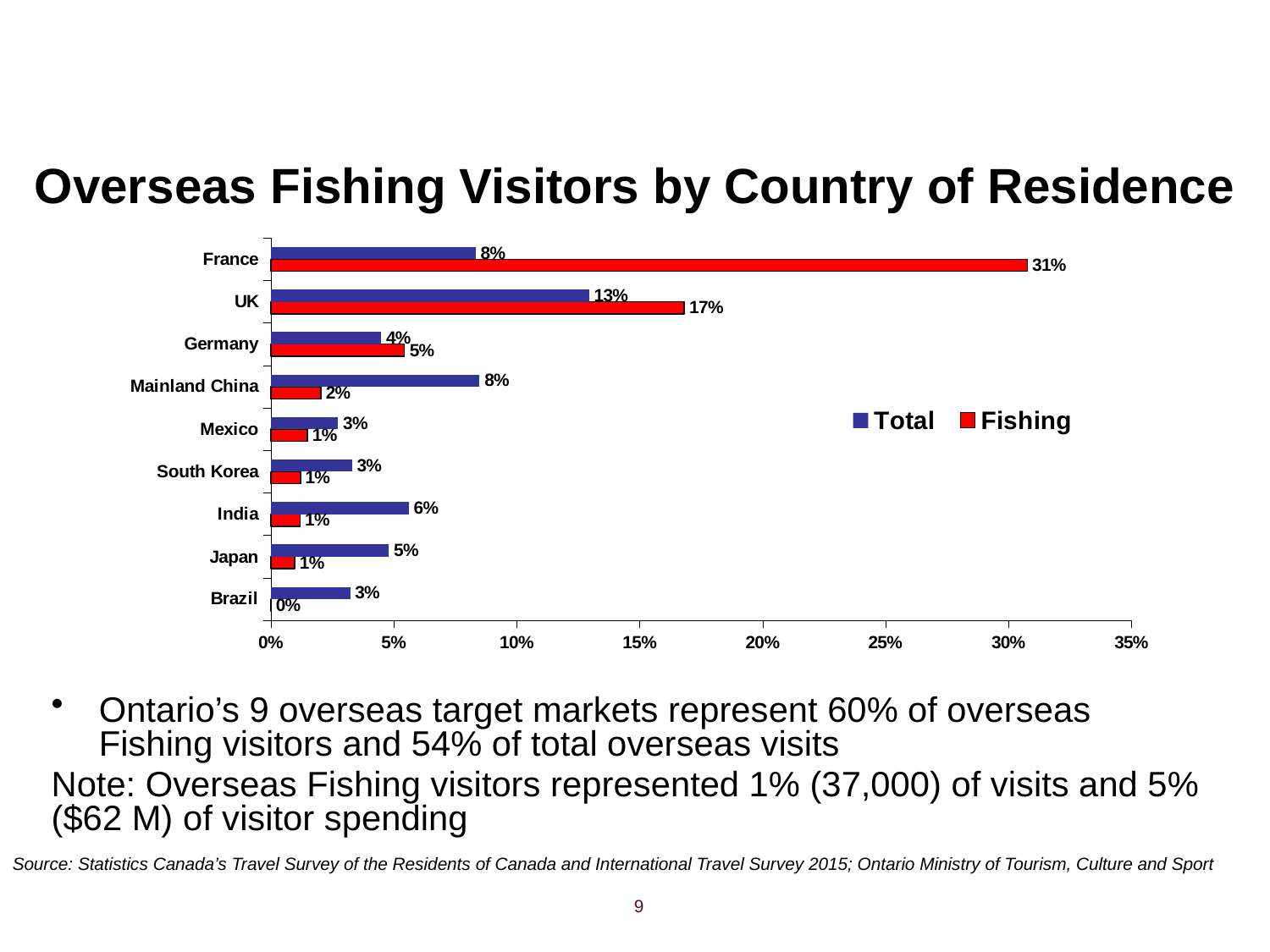
How many series does the legend list? 2 What is the Total value for Mainland China? 8% What kind of chart is shown on the slide? Bar chart Which is larger for Mainland China, the Total value or the Fishing value? Total What is the difference between the Fishing and Total values for France? 23% What is the Fishing value for France? 31% What is the Total value for the UK? 13% Which country has the lowest Fishing value? Brazil What is the Fishing value for Germany? 5% How many countries are shown on the chart? 9 What colour are the Fishing bars? Red Which country has the highest Fishing value? France